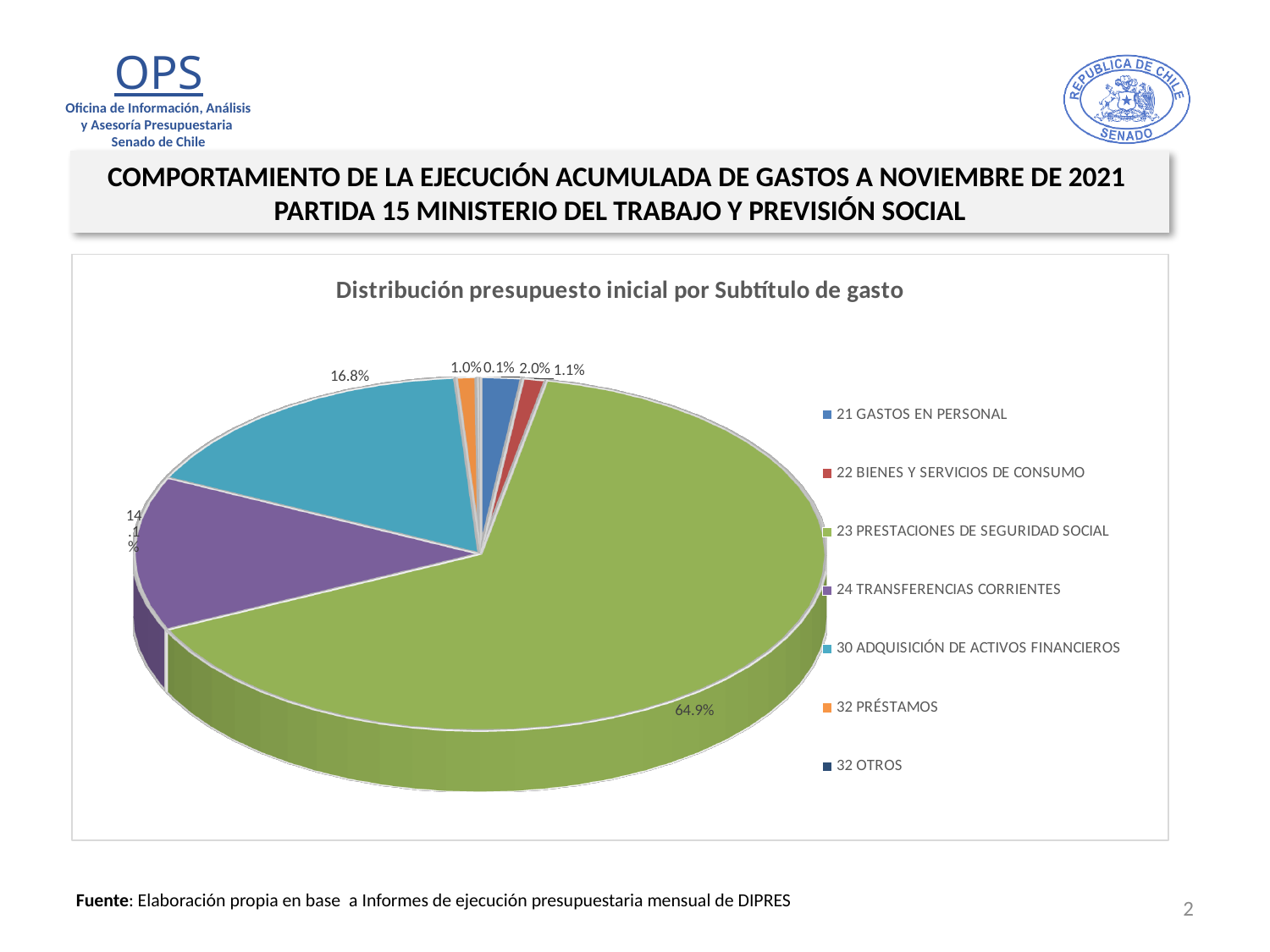
Which is larger, the share for 30 ADQUISICIÓN DE ACTIVOS FINANCIEROS or for 24 TRANSFERENCIAS CORRIENTES? 30 ADQUISICIÓN DE ACTIVOS FINANCIEROS What share of the pie does 32 PRÉSTAMOS represent? 1.0% What is the difference between the share for 30 ADQUISICIÓN DE ACTIVOS FINANCIEROS and the share for 24 TRANSFERENCIAS CORRIENTES? 2.7% What share of the pie does 23 PRESTACIONES DE SEGURIDAD SOCIAL represent? 64.9% Which category has the largest slice of the pie? 23 PRESTACIONES DE SEGURIDAD SOCIAL What share of the pie does 24 TRANSFERENCIAS CORRIENTES represent? 14.1% What type of chart is shown on the slide? Pie chart Which category has the smallest slice of the pie? 32 OTROS What is the title of the chart? Distribución presupuesto inicial por Subtítulo de gasto What colour is the slice for 23 PRESTACIONES DE SEGURIDAD SOCIAL? Green How many categories does the legend of the pie chart list? 7